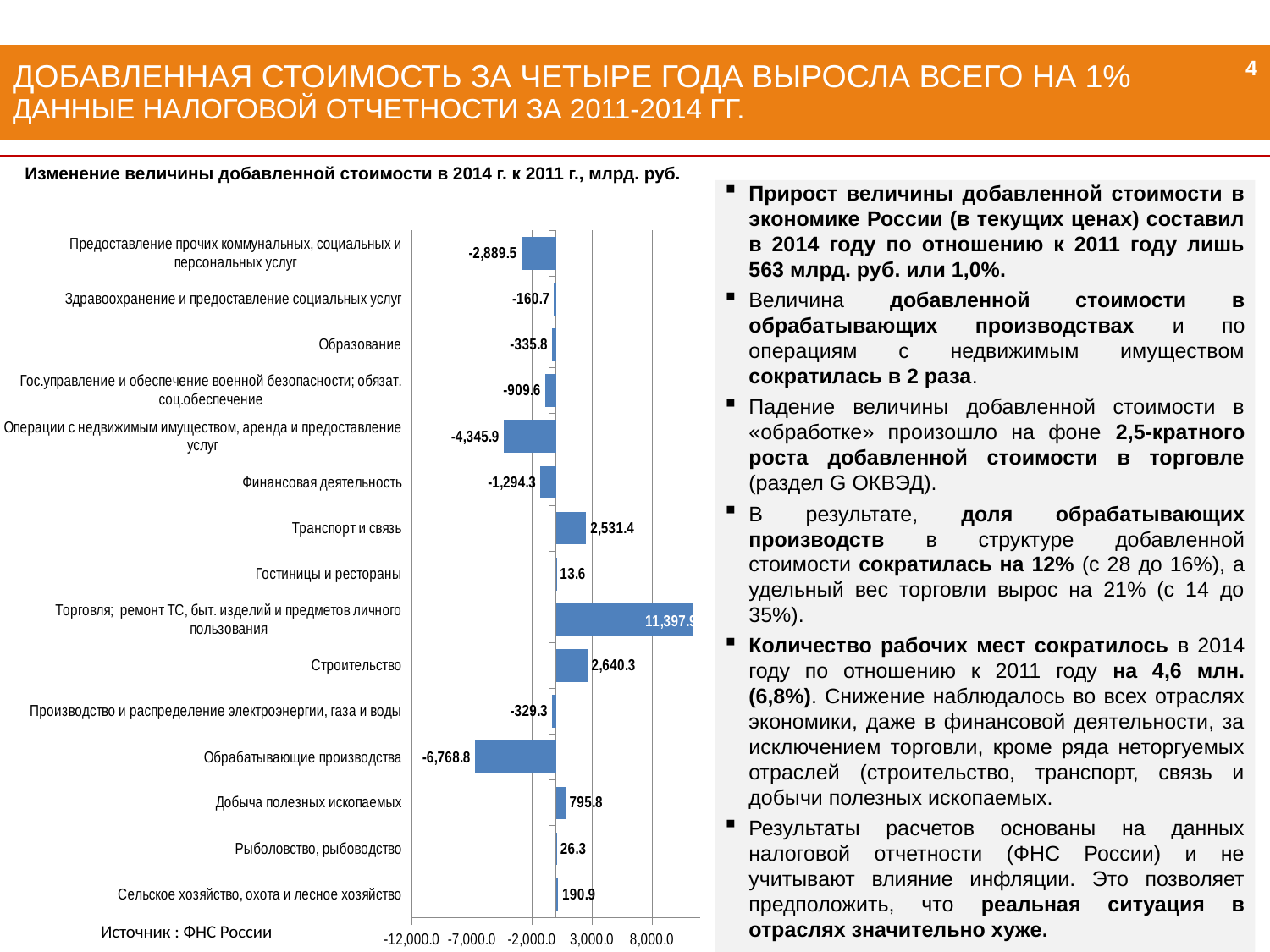
What is the value for Строительство? 2,640.3 How many categories are shown in the chart? 15 What is the difference between the values for Строительство and Транспорт и связь? 108.9 What kind of chart is shown on the slide? Bar chart Which category has the lowest value? Обрабатывающие производства What is the value for Добыча полезных ископаемых? 795.8 Which is larger, the value for Сельское хозяйство, охота и лесное хозяйство or the value for Рыболовство, рыбоводство? Сельское хозяйство, охота и лесное хозяйство Which category has the highest value? Торговля; ремонт ТС, быт. изделий и предметов личного пользования What is the value for Обрабатывающие производства? -6,768.8 What is the title of the chart? Изменение величины добавленной стоимости в 2014 г. к 2011 г., млрд. руб. What is the value for Финансовая деятельность? -1,294.3 What is the value for Операции с недвижимым имуществом, аренда и предоставление услуг? -4,345.9